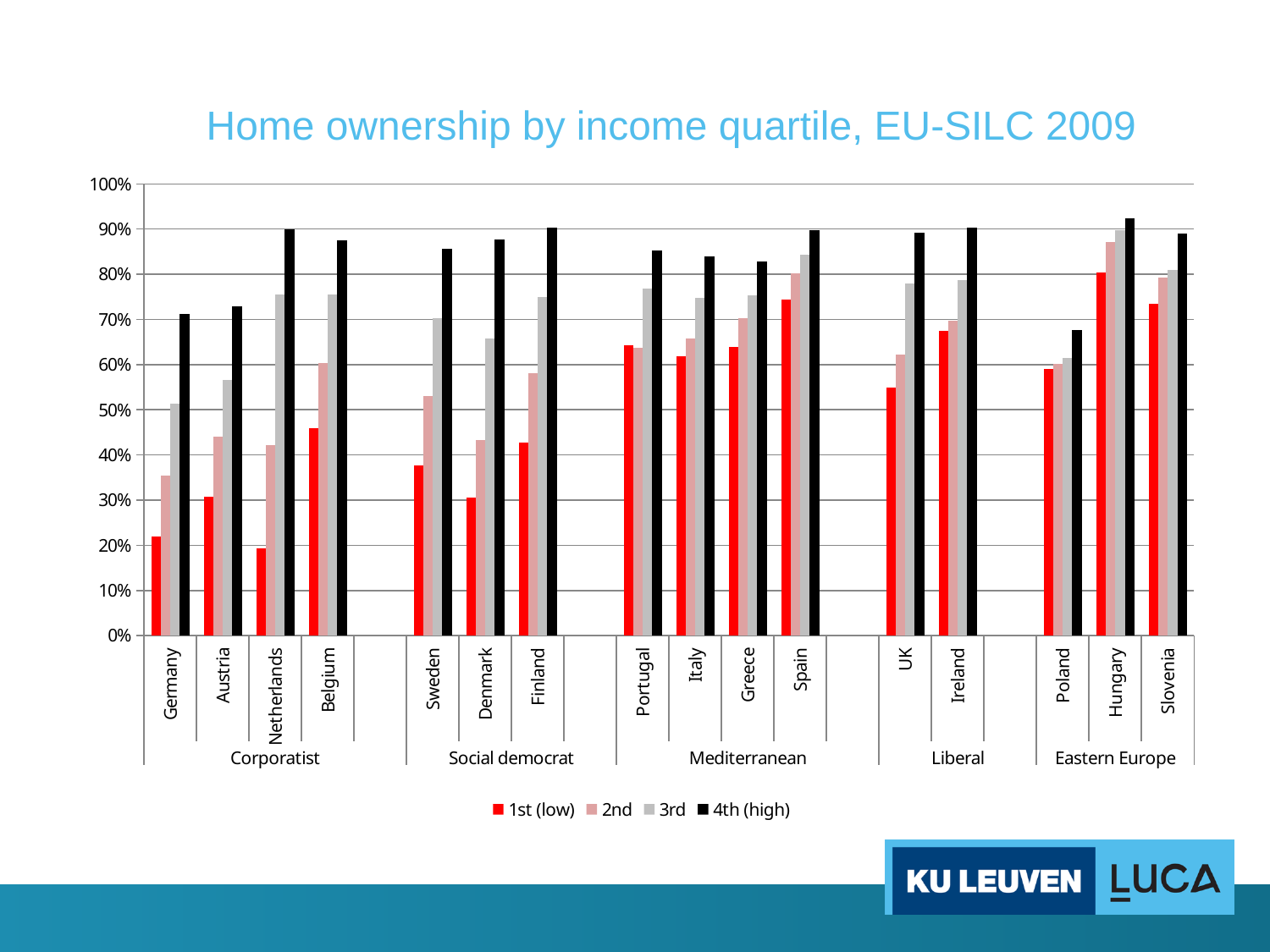
What kind of chart is shown on the slide? bar chart Is the 4th (high) value for the Netherlands greater or less than 80%? greater How many series does the legend list? 4 Which is larger, the 1st (low) value for Spain or the 1st (low) value for Italy? Spain Is the 1st (low) value for Germany greater or less than 30%? less How many countries are shown on the x axis? 16 Which is larger, the 4th (high) value for Germany or the 4th (high) value for Belgium? Belgium Which country has the lowest value for the 4th (high) income quartile? Poland Is the 1st (low) value for Hungary greater or less than 70%? greater What is the title of the chart? Home ownership by income quartile, EU-SILC 2009 Which country has the highest value for the 1st (low) income quartile? Hungary How many country groups (e.g. Corporatist, Liberal) are labelled on the x axis? 5